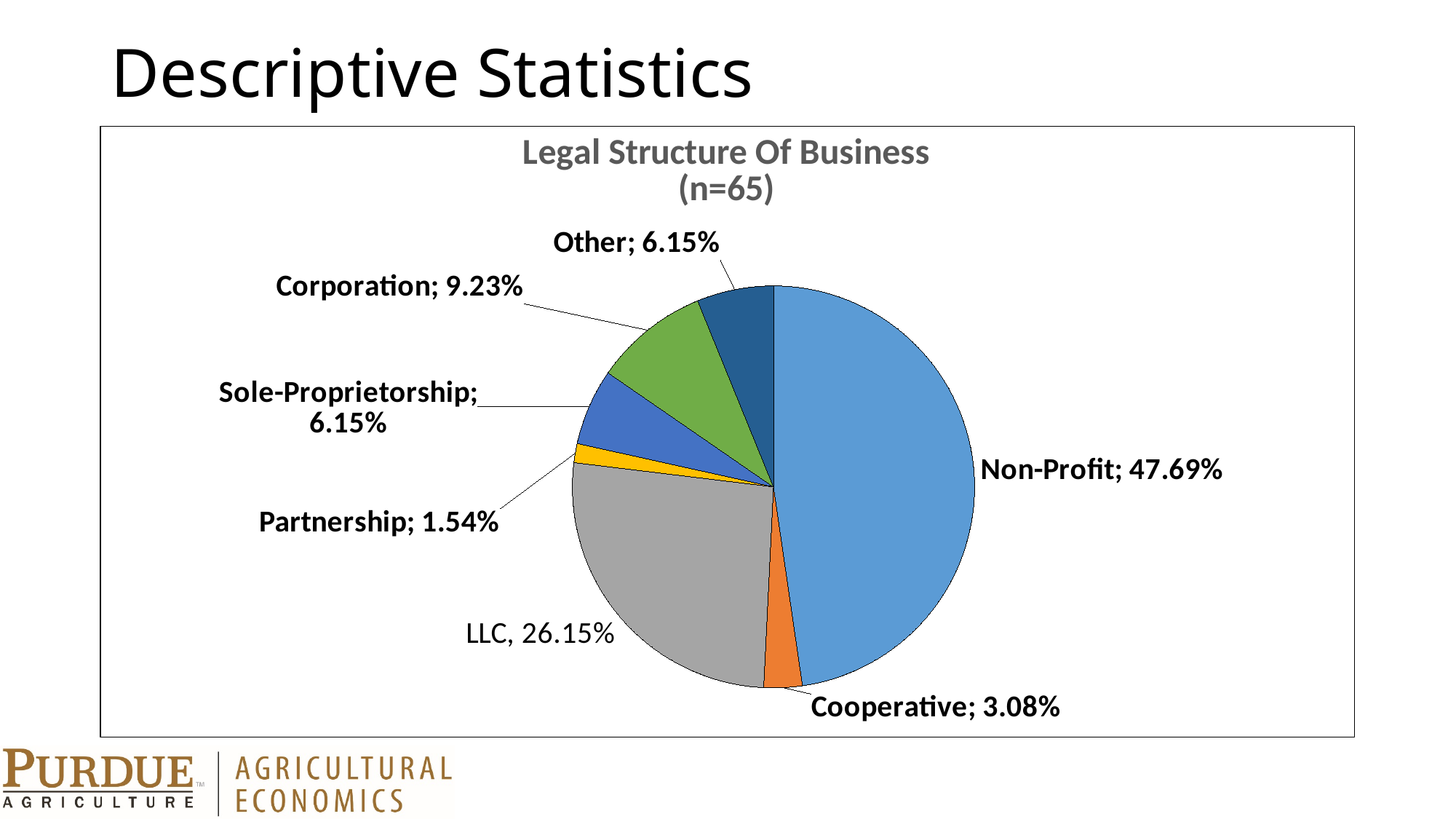
What is the sample size (n) stated in the chart title? 65 What is the title of the chart? Legal Structure Of Business (n=65) Which is larger, the share for Corporation or the share for Sole-Proprietorship? Corporation What percentage is shown for Corporation? 9.23% How many slices does the pie chart have? 7 Which legal structure has the largest share of the pie? Non-Profit Which legal structure has the smallest share of the pie? Partnership What percentage is shown for Cooperative? 3.08% What share of the pie is Non-Profit? 47.69% What share of the pie is LLC? 26.15% What is the difference in percentage points between Non-Profit and LLC? 21.54 What kind of chart is shown on the slide? Pie chart